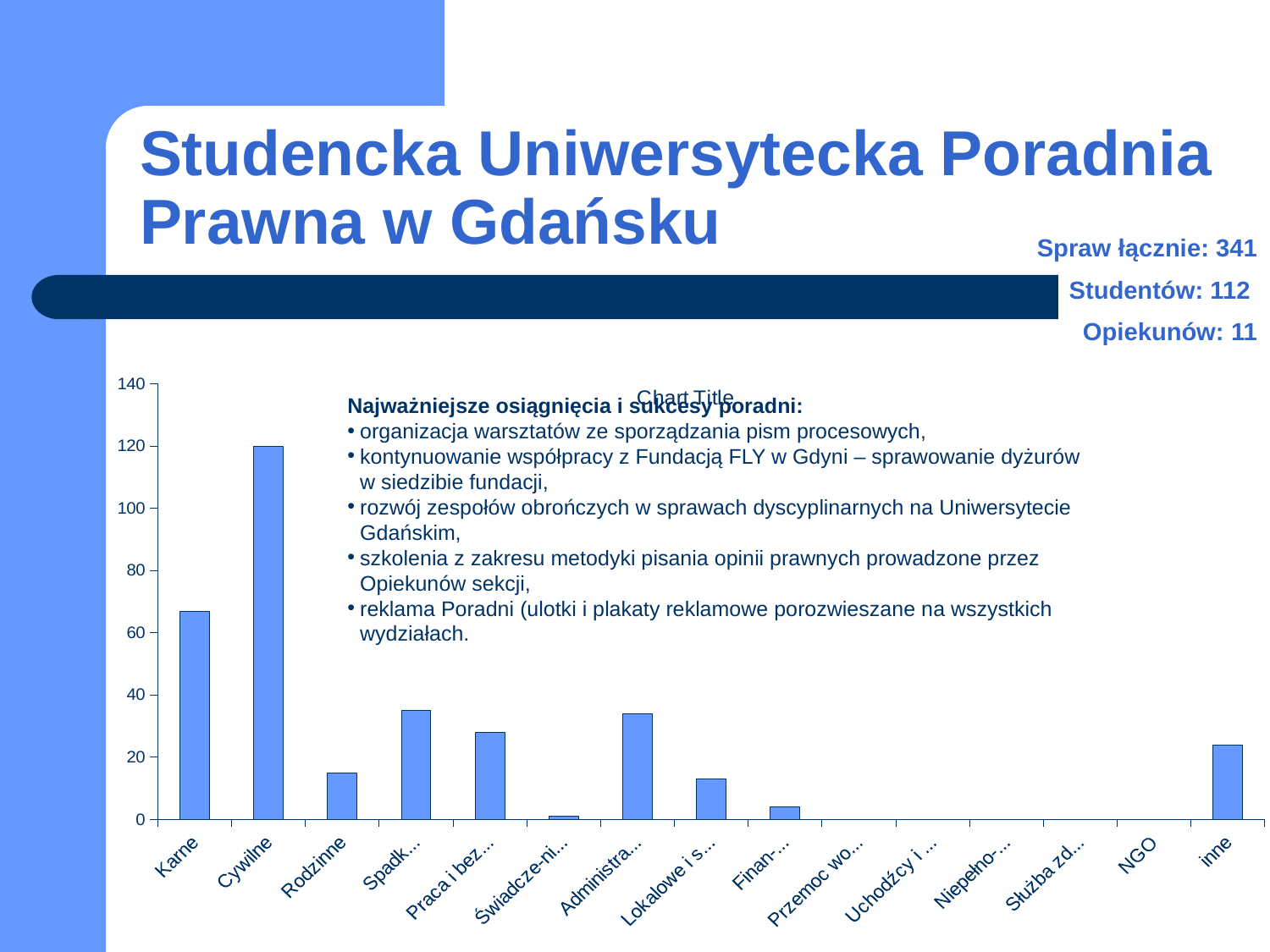
Is the value for Karne greater or less than 80? less Is the value for Administra... greater or less than 40? less What kind of chart is shown on the slide? bar chart What is the value for Cywilne in the chart? 120 Is the value for inne greater or less than 20? greater Which is larger, the value for Karne or the value for Cywilne? Cywilne What is the title shown above the chart? Chart Title How many categories are shown on the x axis of the chart? 15 Which category has the highest bar in the chart? Cywilne Which is larger, the value for Rodzinne or the value for inne? inne